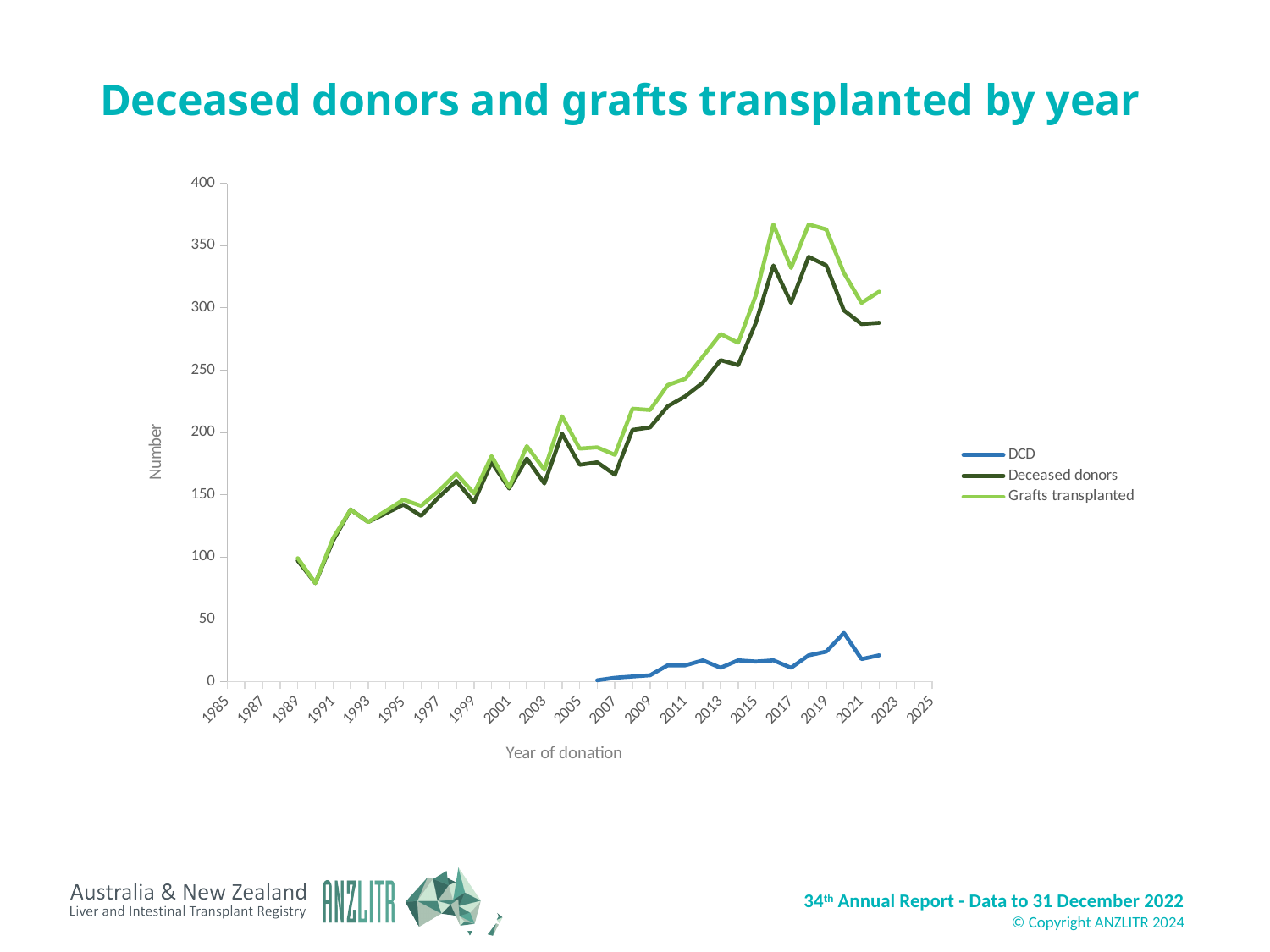
How many series does the legend list? 3 Is the value for Grafts transplanted in 1990 greater or less than 100? less What kind of chart is shown on the slide? line chart Do the Deceased donors values generally rise or fall from 1990 to 2017? rise Which series reaches the highest values on the chart? Grafts transplanted Is the value for DCD in 2020 greater or less than 50? less What is the label of the x axis? Year of donation Is the value for Deceased donors in 2017 greater or less than 350? less In 2017, which is larger: Grafts transplanted or Deceased donors? Grafts transplanted What is the title of the chart? Deceased donors and grafts transplanted by year Which series has the lowest values on the chart? DCD